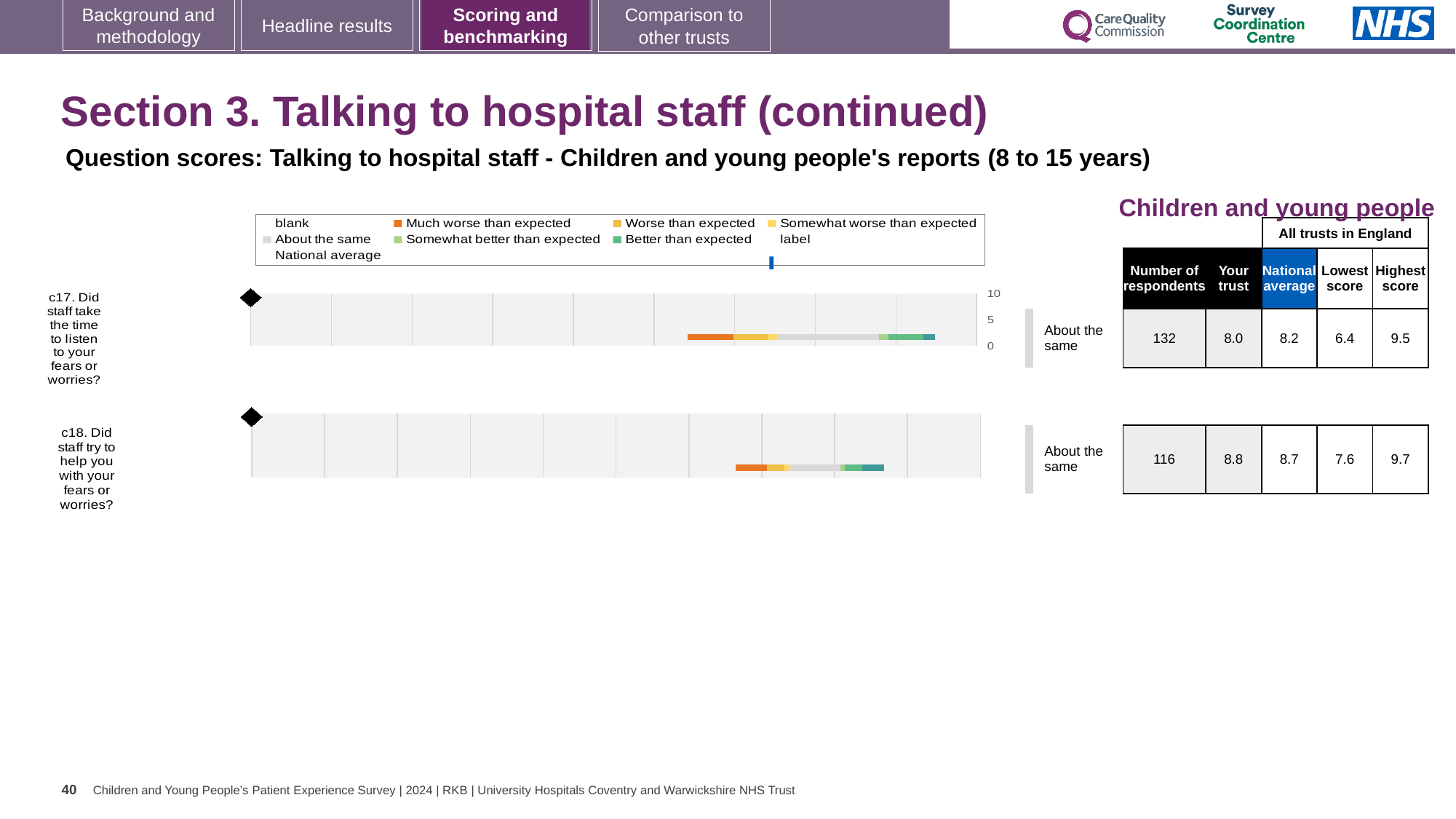
For c18, what is the difference between the highest score and the lowest score across all trusts in England? 2.1 What is the lowest score among all trusts in England for c18? 7.6 How many respondents answered c17? 132 What benchmark category is shown for c17? About the same What colour does the legend use for 'Much worse than expected'? Orange What is the 'Your trust' score for c17 (Did staff take the time to listen to your fears or worries?)? 8.0 For c17, which is higher: the 'Your trust' score or the national average? National average How many survey questions are plotted on the slide? 2 What is the national average score for c18 (Did staff try to help you with your fears or worries?)? 8.7 Which question had more respondents, c17 or c18? c17 What kind of chart is used to show the benchmarking results for c17 and c18? bar chart How many more respondents answered c17 than c18? 16